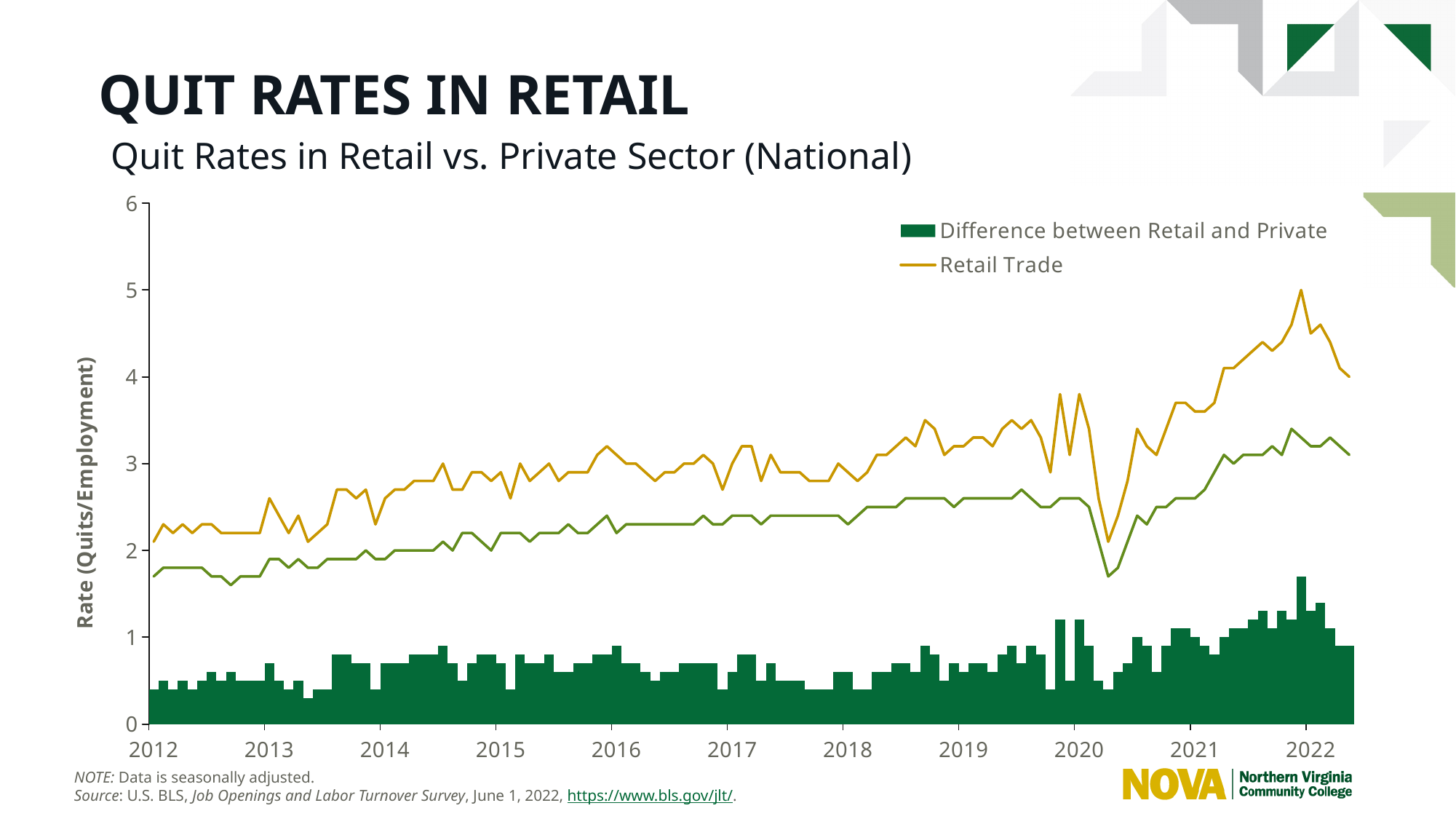
Is the tallest Difference between Retail and Private bar, in late 2021, greater or less than 1? greater Is the Difference between Retail and Private bar at the start of 2012 greater or less than 1? less What is the title of the chart? Quit Rates in Retail vs. Private Sector (National) What kind of chart is shown on the slide? A combined bar and line chart Overall, does the Retail Trade quit rate rise or fall from 2012 to 2022? rise In which year does the Retail Trade line reach its highest point? 2021 What is the first year shown on the horizontal axis? 2012 How many series does the chart legend list? 2 What is the label on the vertical axis of the chart? Rate (Quits/Employment) Which is higher at the start of 2019: the Retail Trade line or the Difference between Retail and Private bar? Retail Trade Is the Retail Trade quit rate at its lowest point in 2020 greater or less than 3? less